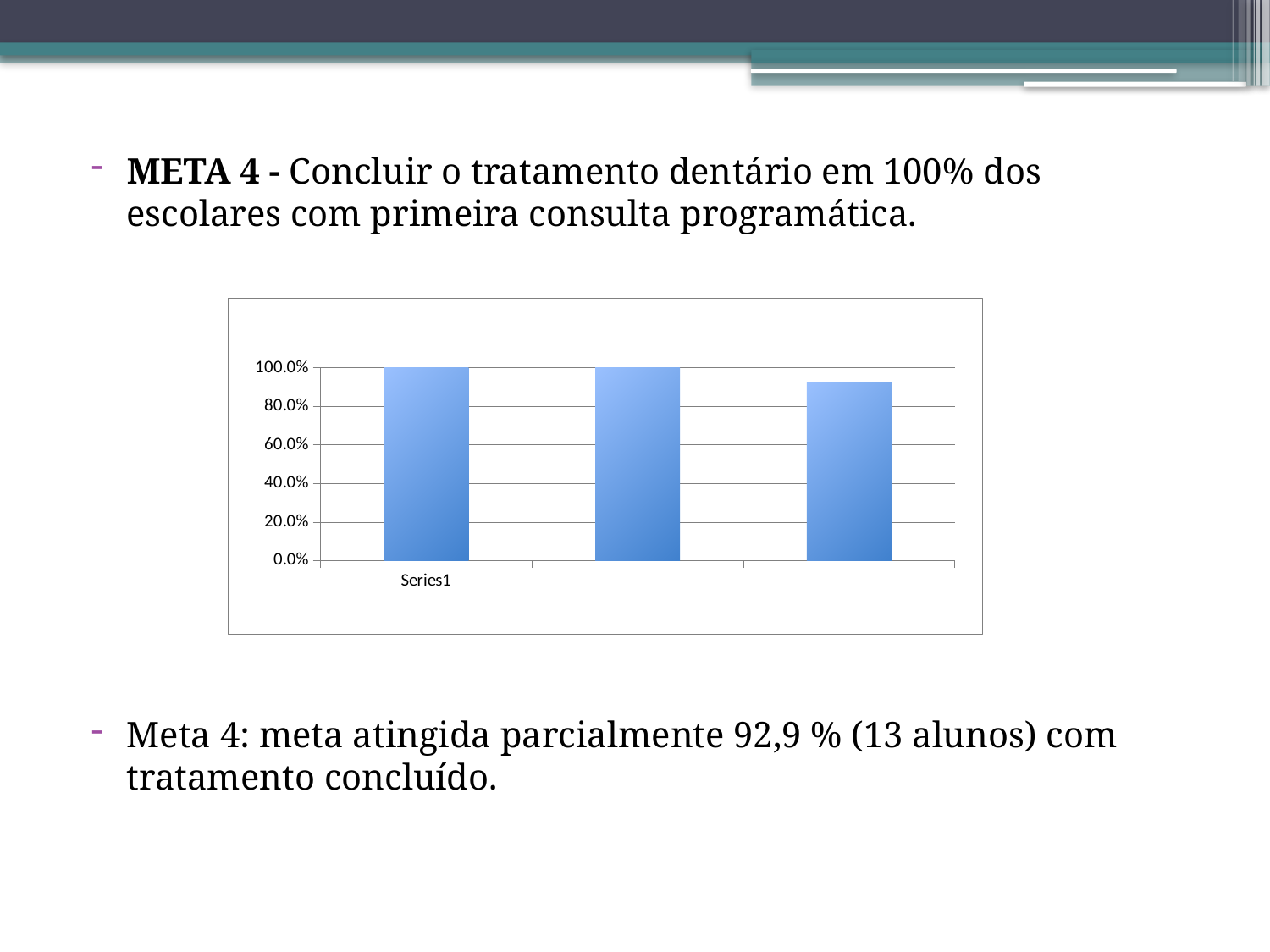
Is the value of the third (rightmost) bar greater or less than 100.0%? less What colour are the bars in the chart? blue What kind of chart is shown on the slide? bar chart How many bars are plotted in the chart? 3 What is the value of the bar labelled Series1? 100.0% Is the value of the third (rightmost) bar greater or less than 80.0%? greater What is the highest value shown on the vertical axis of the chart? 100.0% Which bar is the lowest in the chart? the third (rightmost) bar Do the bar values rise or fall from the second bar to the third bar? fall Which is larger, the bar labelled Series1 or the third (rightmost) bar? Series1